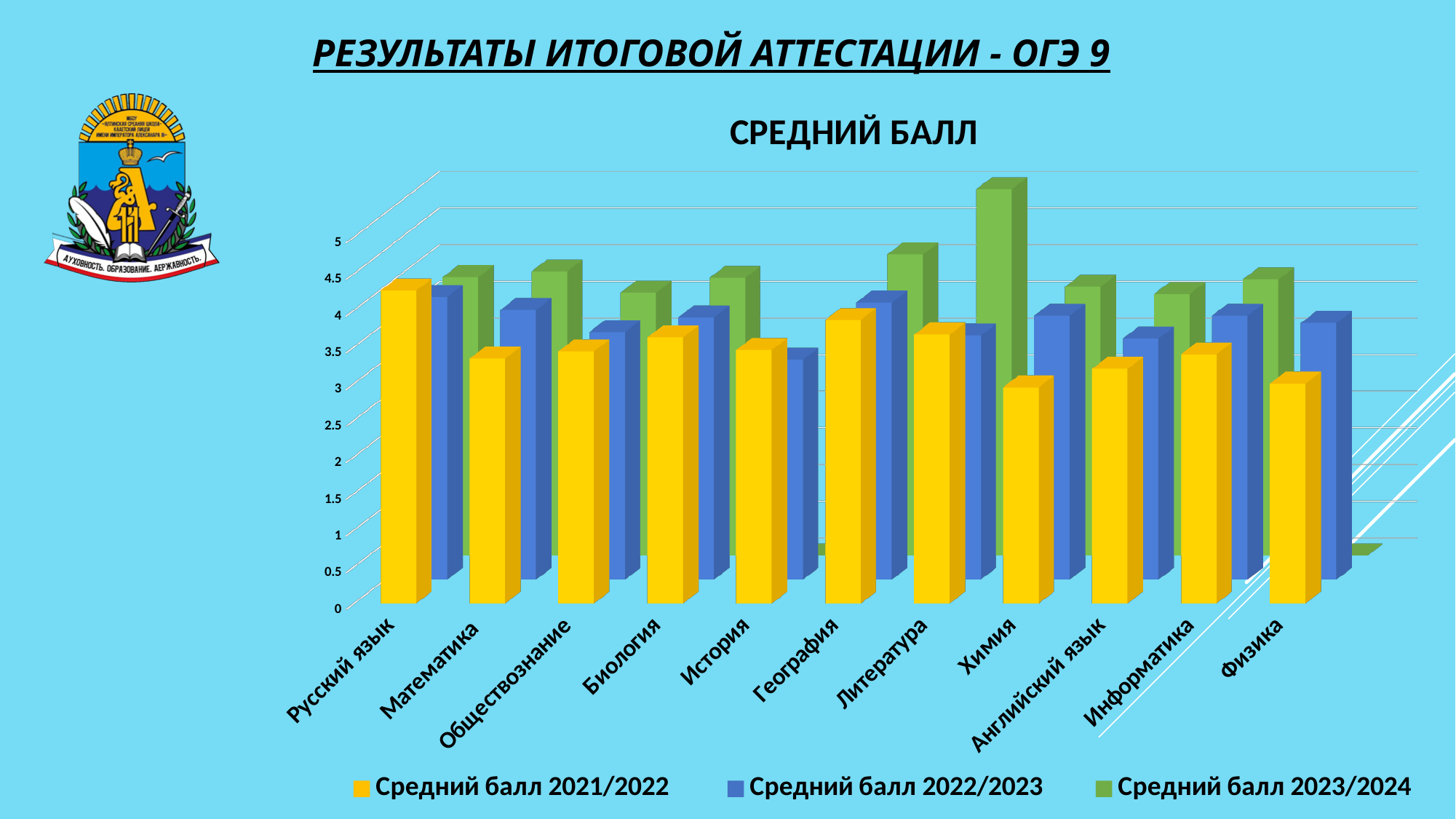
Which subject has the highest value for the series 'Средний балл 2021/2022'? Русский язык Is the value for Русский язык in the series 'Средний балл 2021/2022' greater or less than 4? greater For Химия, which is larger: the value for 'Средний балл 2021/2022' or for 'Средний балл 2023/2024'? Средний балл 2023/2024 Which colour represents the series 'Средний балл 2021/2022' in the legend? yellow What kind of chart is shown on the slide? bar chart In the series 'Средний балл 2021/2022', which is larger: the value for Русский язык or for Математика? Русский язык Which subject has the highest value for the series 'Средний балл 2023/2024'? Литература Is the value for Химия in the series 'Средний балл 2021/2022' greater or less than 4? less What is the title of the chart? СРЕДНИЙ БАЛЛ How many series does the chart legend list? 3 How many subjects (categories) are shown on the x axis of the chart? 11